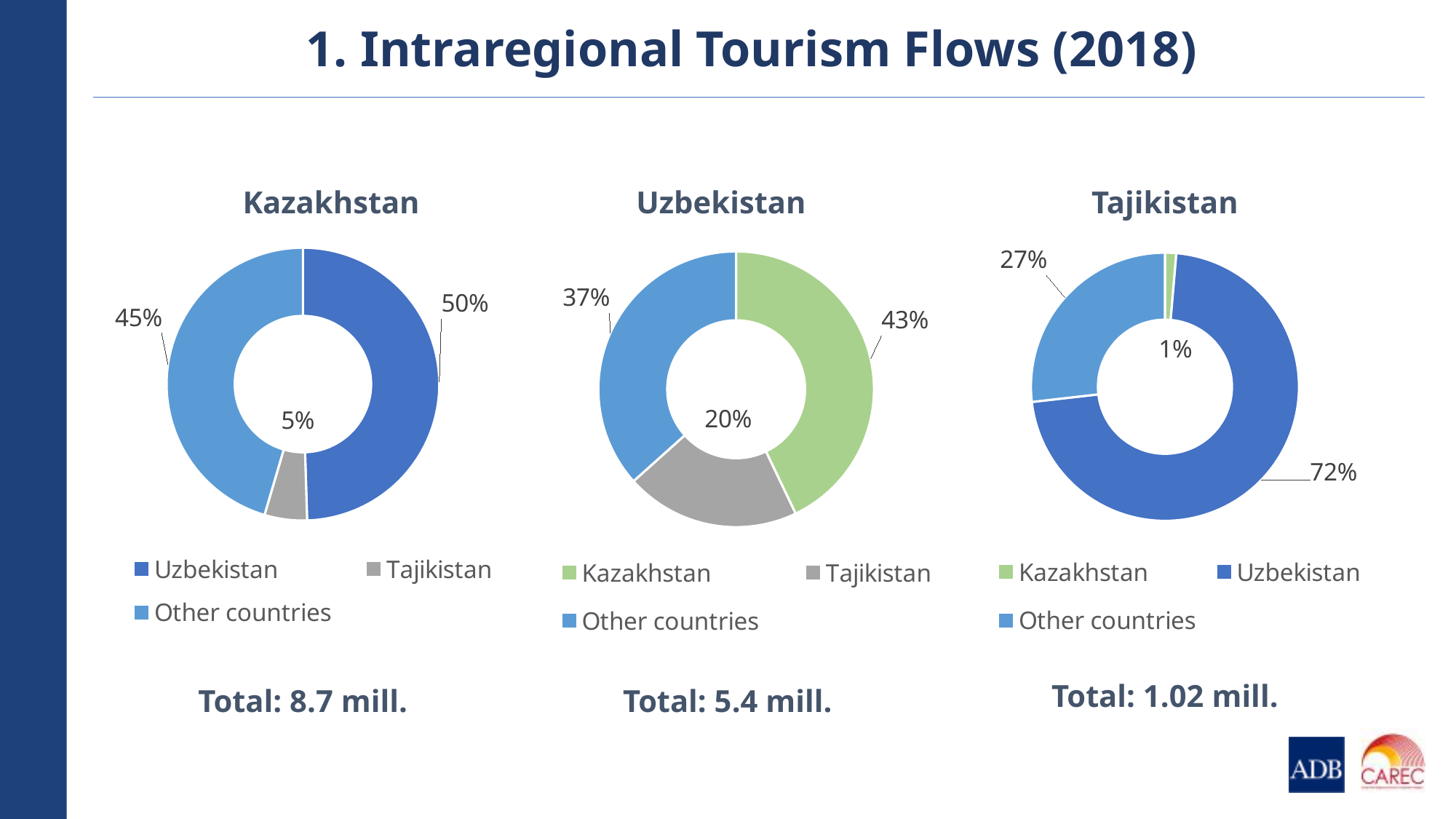
In the Kazakhstan chart, which is larger: the share for Uzbekistan or the share for Other countries? Uzbekistan In the Uzbekistan chart, what is the difference between the Kazakhstan share and the Tajikistan share? 23 percentage points What type of chart is used for the Tajikistan chart? Doughnut chart In the Uzbekistan chart, what share comes from Other countries? 37% In the Tajikistan chart, which category has the largest share? Uzbekistan In the Kazakhstan chart, what share comes from Tajikistan? 5% In the Tajikistan chart, which category has the smallest share? Kazakhstan How many categories does the Uzbekistan chart show? 3 In the Kazakhstan chart, what share of tourism flows comes from Uzbekistan? 50% What total is shown below the Tajikistan chart? Total: 1.02 mill. In the Uzbekistan chart, what share comes from Kazakhstan? 43% What is the title of the slide? 1. Intraregional Tourism Flows (2018)